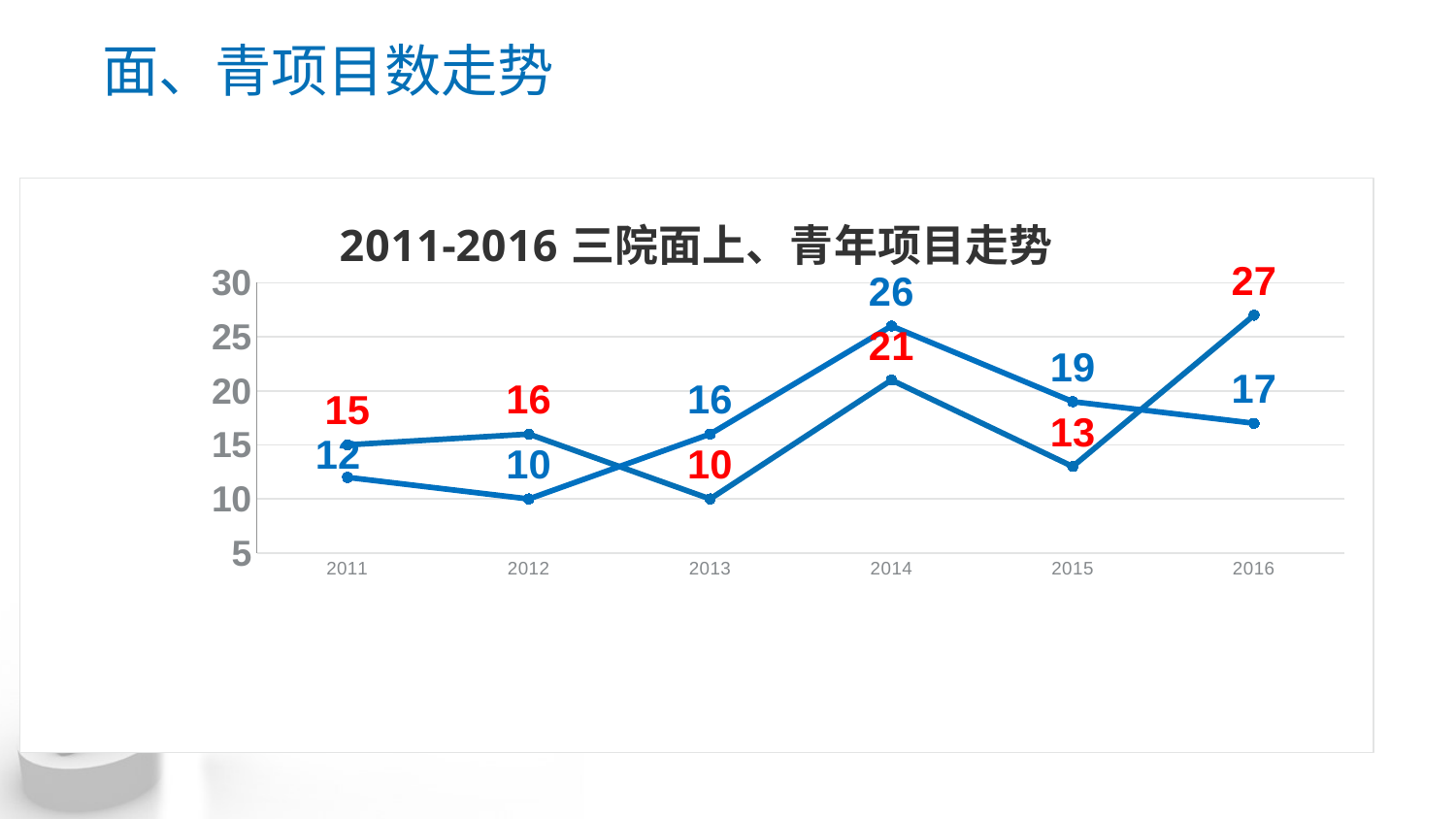
In 2014, what is the difference between the blue-labelled value and the red-labelled value? 5 In which year does the series with blue data labels reach its highest value? 2014 What is the value of the series with blue data labels in 2015? 19 What is the lowest value of the series with red data labels? 10 What is the value of the series with red data labels in 2014? 21 What is the value of the series with blue data labels in 2011? 12 What kind of chart is shown on the slide? line chart How many lines are plotted in the chart? 2 What is the title of the chart? 2011-2016 三院面上、青年项目走势 In 2016, which series has the larger value, the one with red labels or the one with blue labels? the series with red labels In which year does the series with red data labels reach its highest value? 2016 How many years are shown on the x axis of the chart? 6